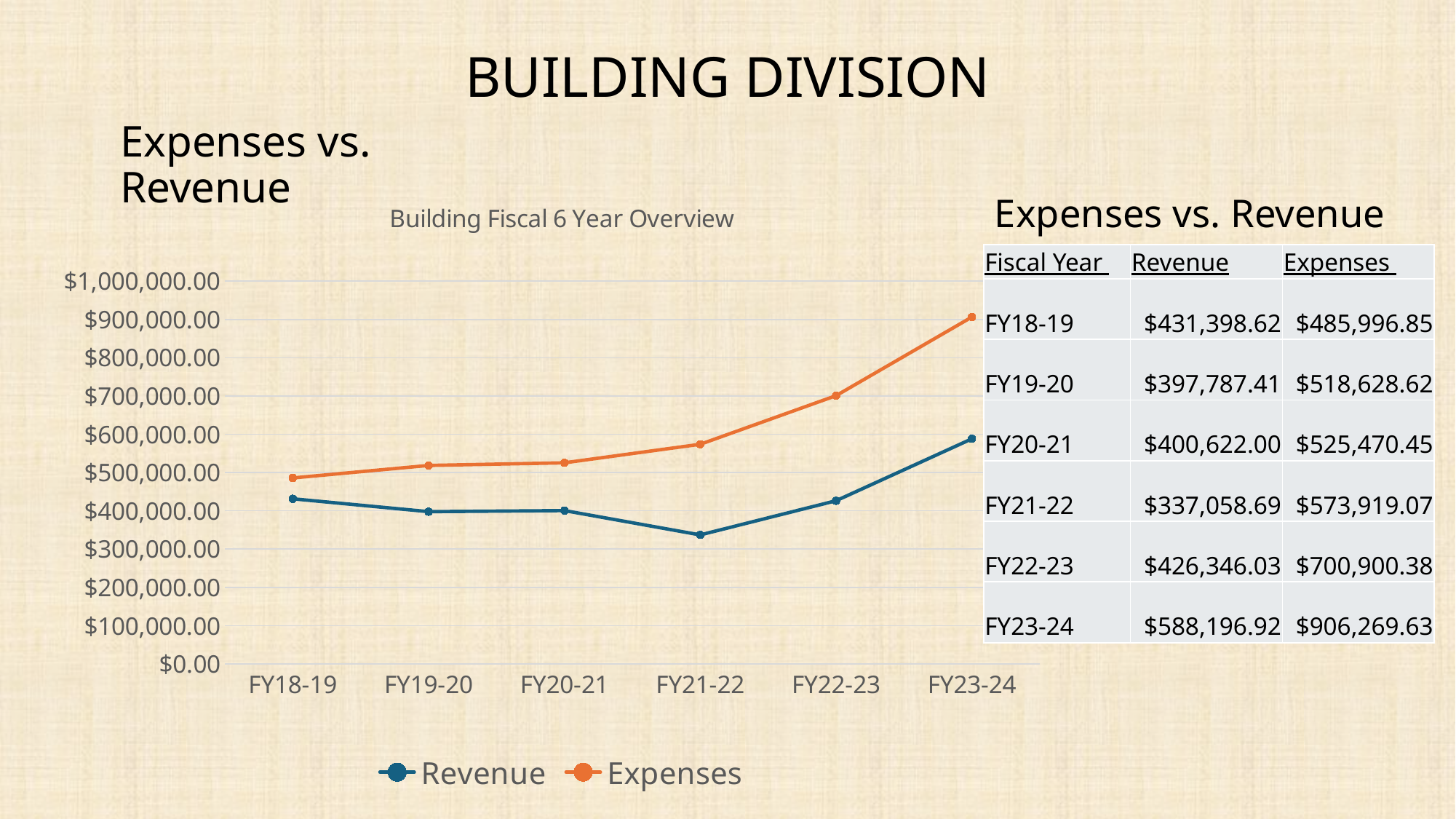
What is the difference between Expenses and Revenue in FY23-24? $318,072.71 What type of chart is shown on the slide? line chart Which is larger in FY22-23, Revenue or Expenses? Expenses What is the title of the chart? Building Fiscal 6 Year Overview Do Expenses rise or fall from FY18-19 to FY23-24? rise In which fiscal year are Expenses highest? FY23-24 How many fiscal years are plotted on the x axis of the chart? 6 How many series does the chart legend list? 2 In which fiscal year is Revenue lowest? FY21-22 Is the Expenses value for FY22-23 greater or less than $600,000.00? greater What is the Expenses value for FY23-24? $906,269.63 What is the Revenue value for FY21-22? $337,058.69